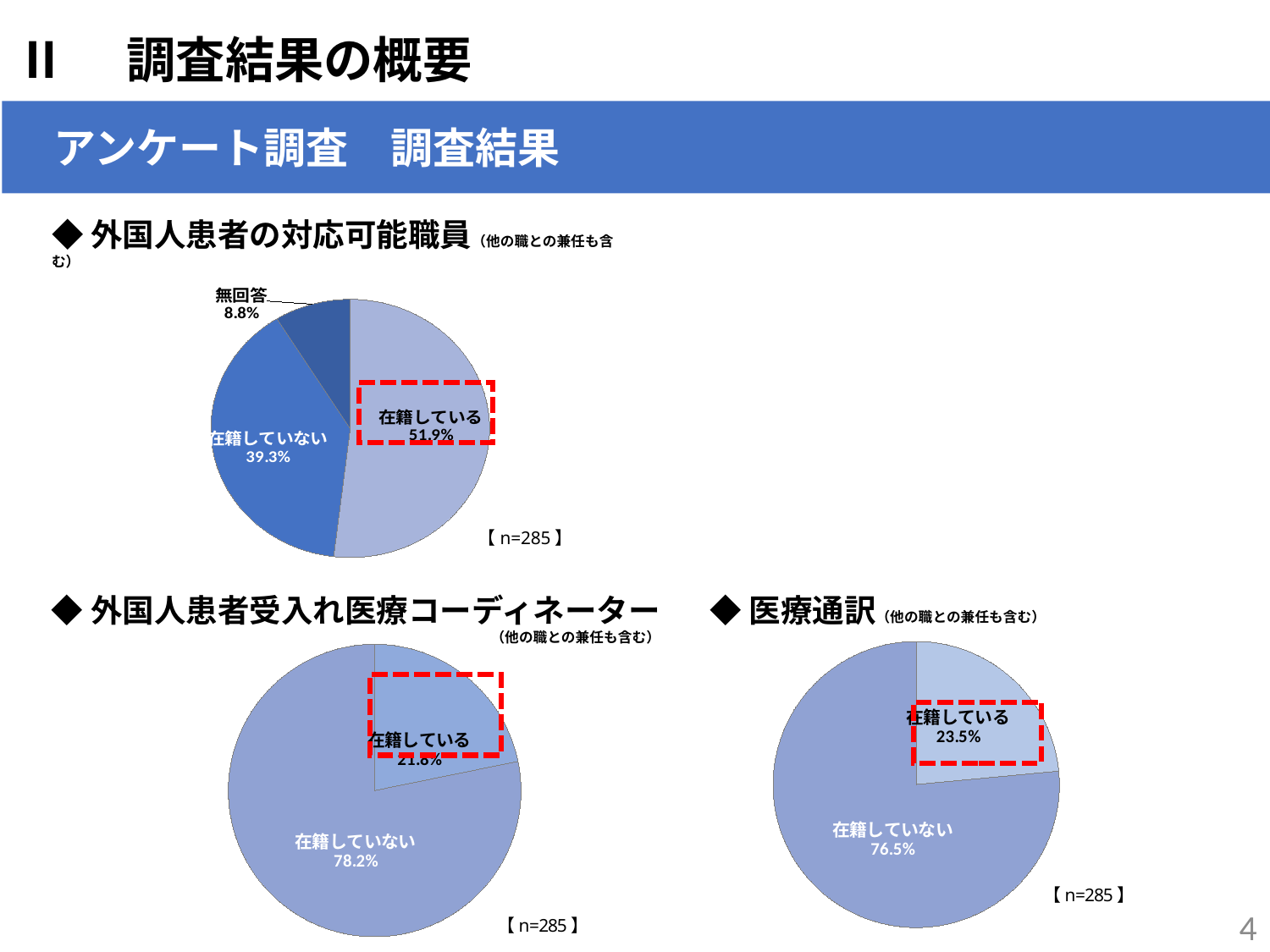
In the bottom-left chart (外国人患者受入れ医療コーディネーター), what percentage is shown for 在籍していない? 78.2% In the top chart (外国人患者の対応可能職員), what percentage is shown for 無回答? 8.8% In the bottom-left chart (外国人患者受入れ医療コーディネーター), which is larger, 在籍している or 在籍していない? 在籍していない In the bottom-right chart (医療通訳), what percentage is shown for 在籍している? 23.5% In the top chart (外国人患者の対応可能職員), how many slices does the pie have? 3 In the top chart (外国人患者の対応可能職員), which category has the smallest share? 無回答 What type of chart is used for the bottom-right chart (医療通訳)? Pie chart In the top chart (外国人患者の対応可能職員), what percentage is shown for 在籍している? 51.9% In the top chart (外国人患者の対応可能職員), what percentage is shown for 在籍していない? 39.3% In the top chart (外国人患者の対応可能職員), which category has the largest share? 在籍している In the bottom-right chart (医療通訳), what percentage is shown for 在籍していない? 76.5% In the top chart (外国人患者の対応可能職員), what is the difference between 在籍している and 在籍していない? 12.6%